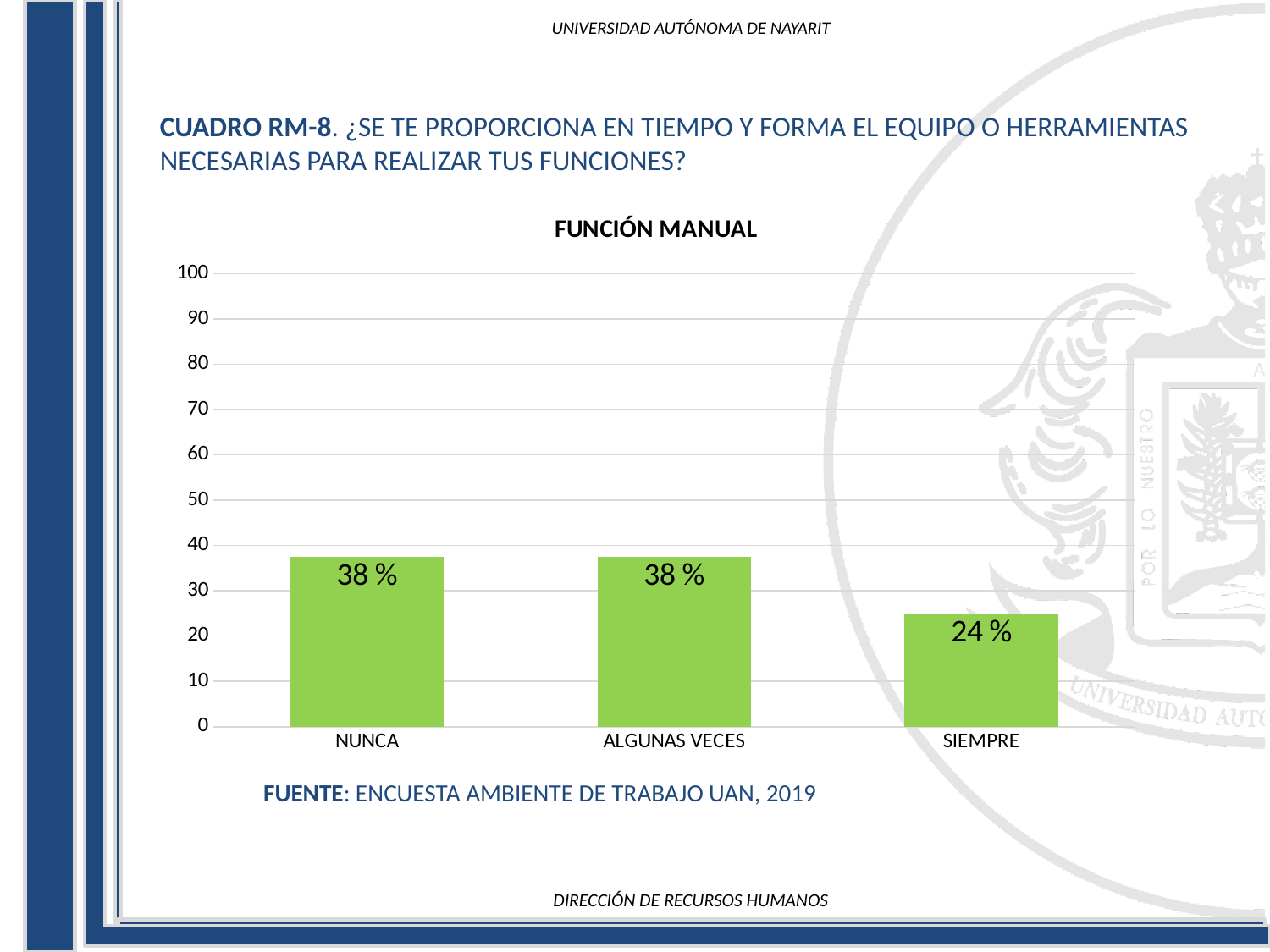
What kind of chart is shown on the slide? bar chart How many categories are shown on the x axis? 3 What is the difference between the values for NUNCA and SIEMPRE? 14 % Which is larger, the value for ALGUNAS VECES or the value for SIEMPRE? ALGUNAS VECES What is the value for NUNCA? 38 % What is the highest value shown on the vertical axis? 100 Is the value for NUNCA greater or less than 30? greater What is the value for ALGUNAS VECES? 38 % Is the value for SIEMPRE greater or less than 30? less Which category has the lowest value? SIEMPRE What is the title of the chart? FUNCIÓN MANUAL What is the value for SIEMPRE? 24 %